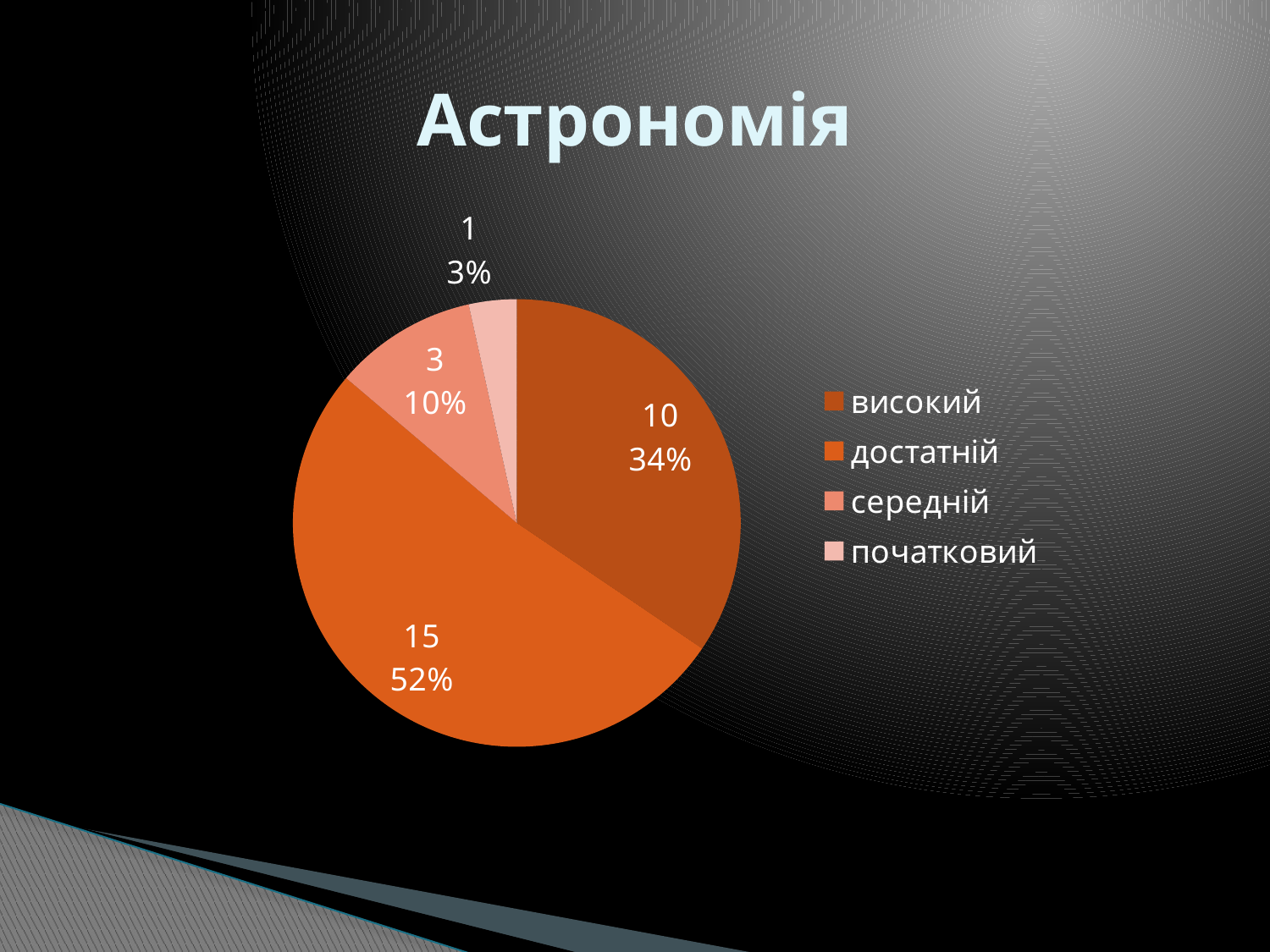
Which category has the smallest slice? початковий How many slices does the pie chart have? 4 What is the value for середній? 3 What kind of chart is shown on the slide? pie chart Which category has the largest slice? достатній What is the value for достатній? 15 What is the value for високий? 10 What is the value for початковий? 1 What share of the pie does достатній take? 52% What share of the pie does високий take? 34% What is the difference between the values for достатній and високий? 5 What is the title of the chart? Астрономія